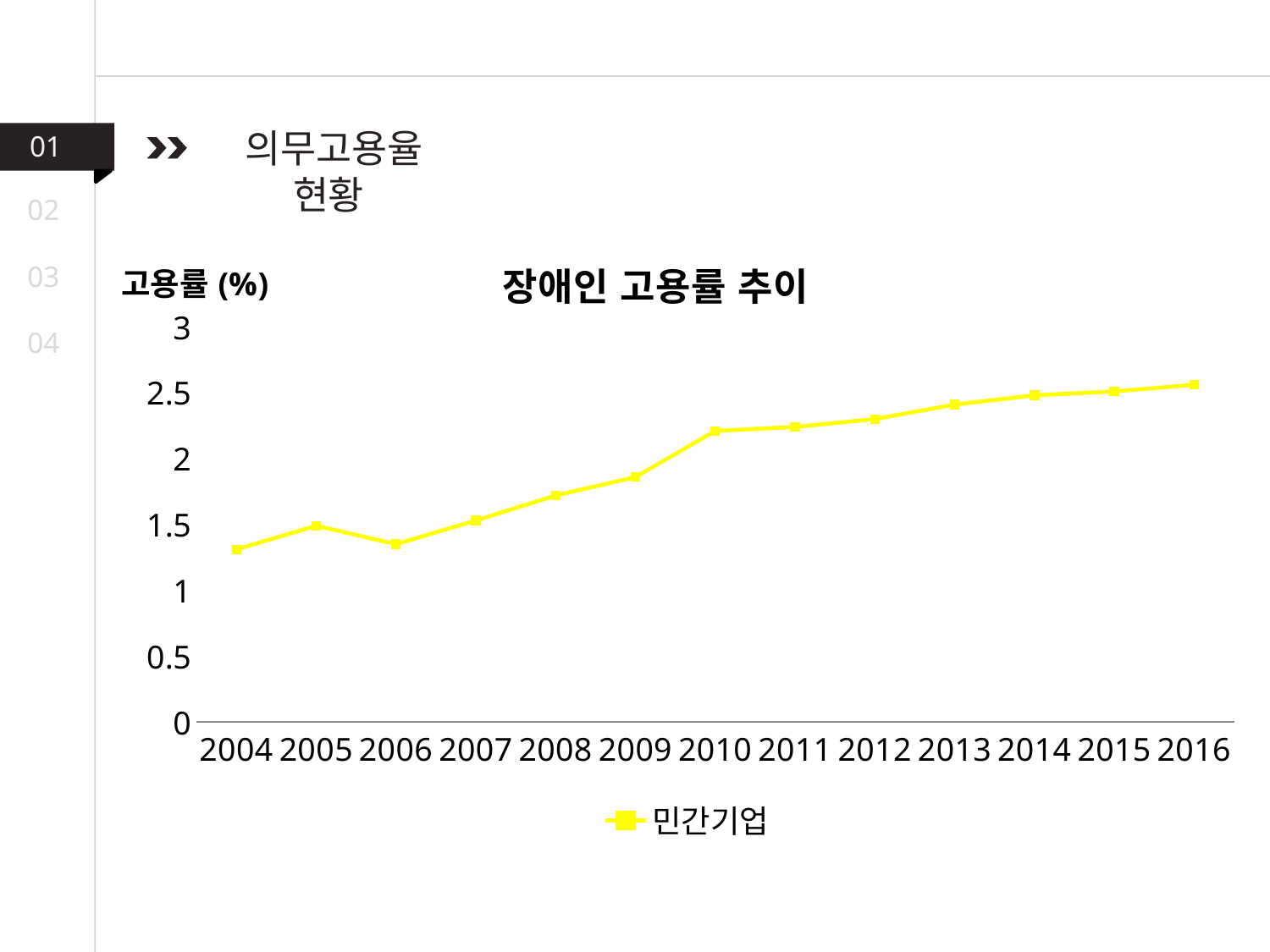
What is the name of the series shown in the legend? 민간기업 Is the value for 2010 greater or less than 2? greater How many series does the legend list? 1 What kind of chart is shown on the slide? line chart Which year has the highest value for 민간기업? 2016 How many years are plotted along the x axis? 13 What is the title of the chart? 장애인 고용률 추이 Is the value for 2004 greater or less than 1.5? less Overall, do the values rise or fall from 2004 to 2016? rise Is the value for 2009 greater or less than 2? less Which is larger, the value for 2005 or the value for 2006? 2005